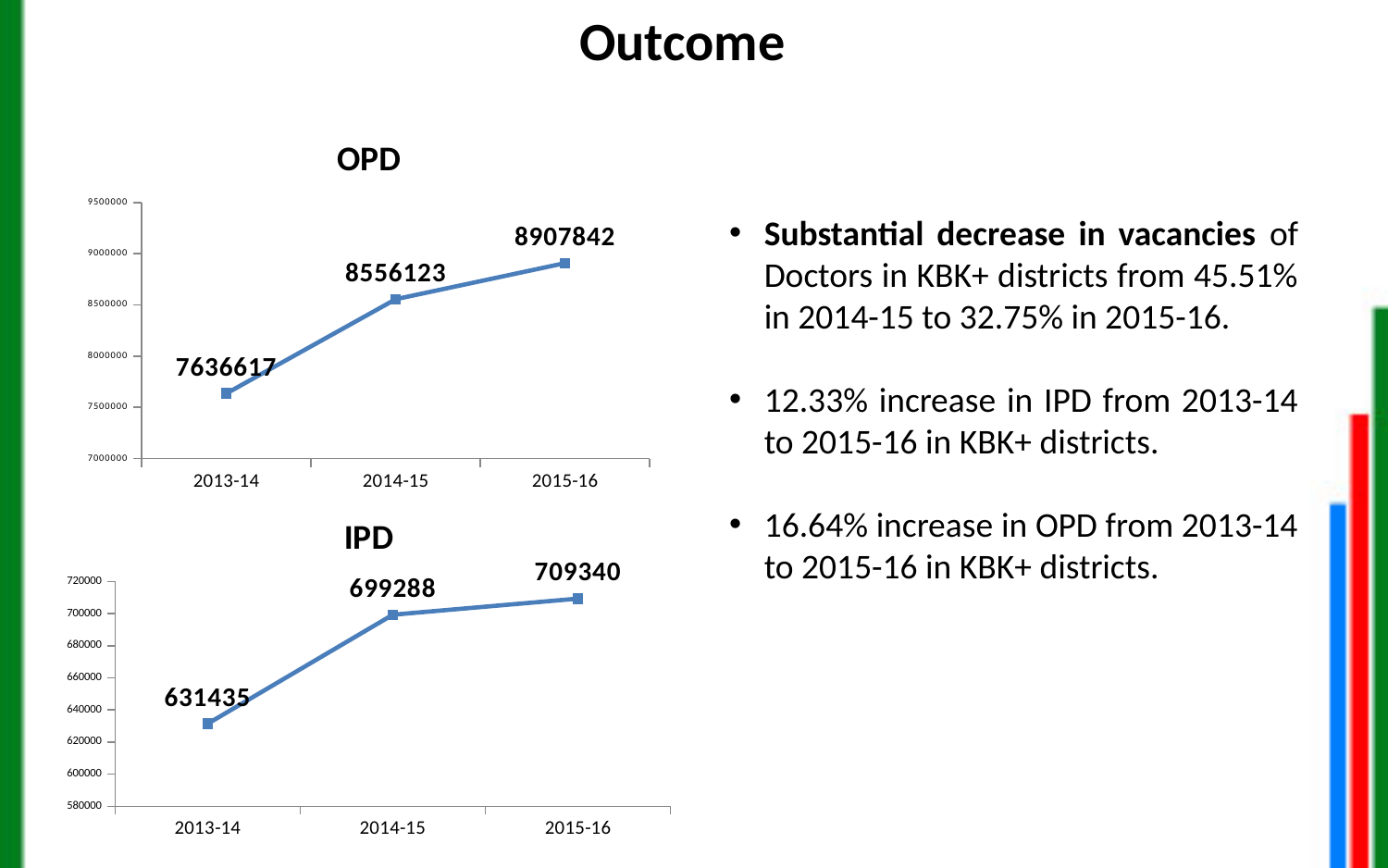
In the OPD chart, which year has the highest value? 2015-16 In the OPD chart, is the value for 2013-14 greater or less than 8000000? less What is the title of the lower chart on the slide? IPD In the IPD chart, which year has the lowest value? 2013-14 In the IPD chart, which is larger, the value for 2014-15 or 2015-16? 2015-16 What kind of chart is the OPD chart? line chart In the OPD chart, what is the value for 2014-15? 8556123 In the OPD chart, what is the difference between the 2015-16 and 2013-14 values? 1271225 In the IPD chart, do the values rise or fall from 2013-14 to 2015-16? rise In the IPD chart, what is the value for 2013-14? 631435 In the IPD chart, what is the difference between the 2014-15 and 2013-14 values? 67853 How many data points are plotted in the IPD chart? 3